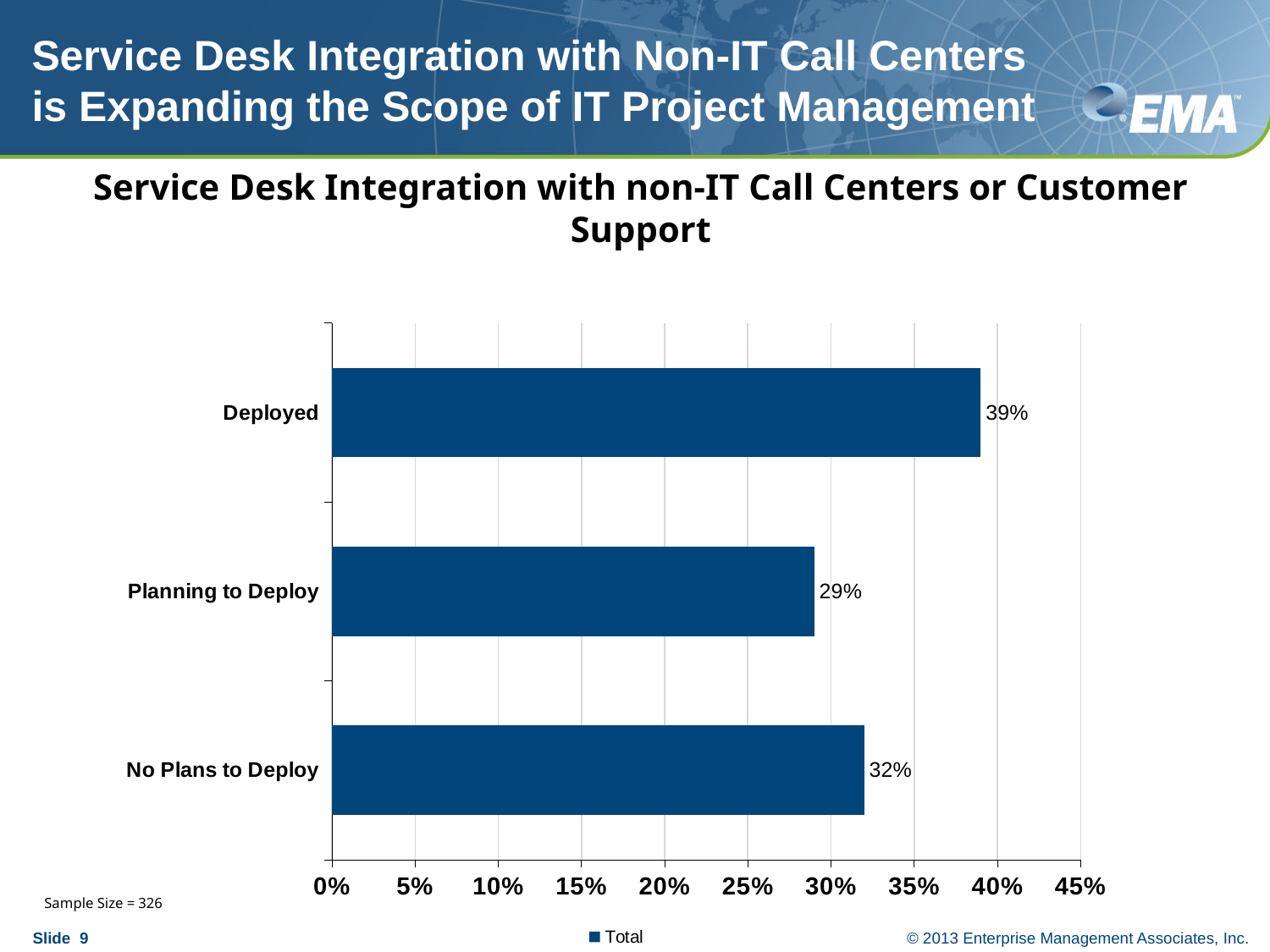
What is the value for Deployed? 39% How many categories are shown in the chart? 3 Which category has the highest value? Deployed Is the value for Deployed greater or less than 35%? greater Which is larger, the value for No Plans to Deploy or the value for Planning to Deploy? No Plans to Deploy What is the difference between the values for No Plans to Deploy and Planning to Deploy? 3% What is the value for No Plans to Deploy? 32% What is the value for Planning to Deploy? 29% What is the difference between the values for Deployed and Planning to Deploy? 10% Which category has the lowest value? Planning to Deploy What is the title of the chart? Service Desk Integration with non-IT Call Centers or Customer Support What kind of chart is shown on the slide? Bar chart